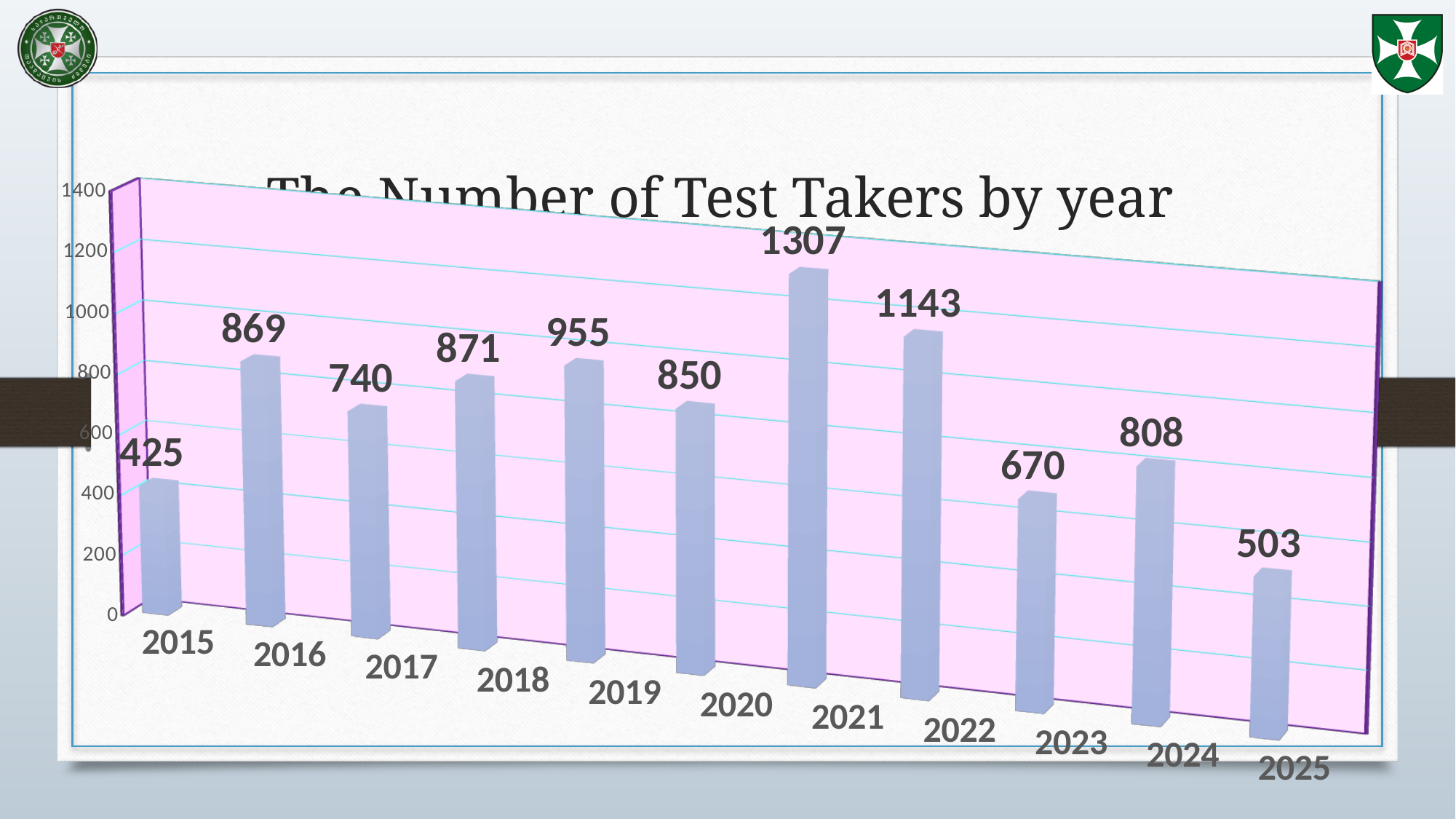
How many years are shown on the chart? 11 Which year has the highest number of test takers? 2021 Is the value for 2019 greater or less than 1000? less What kind of chart is shown on the slide? bar chart What is the title of the chart? The Number of Test Takers by year Do the values rise or fall from 2022 to 2024? fall Which year has the lowest number of test takers? 2015 What is the number of test takers in 2021? 1307 What is the number of test takers in 2025? 503 What is the number of test takers in 2015? 425 What is the difference in test takers between 2021 and 2022? 164 Which year had more test takers, 2016 or 2018? 2018